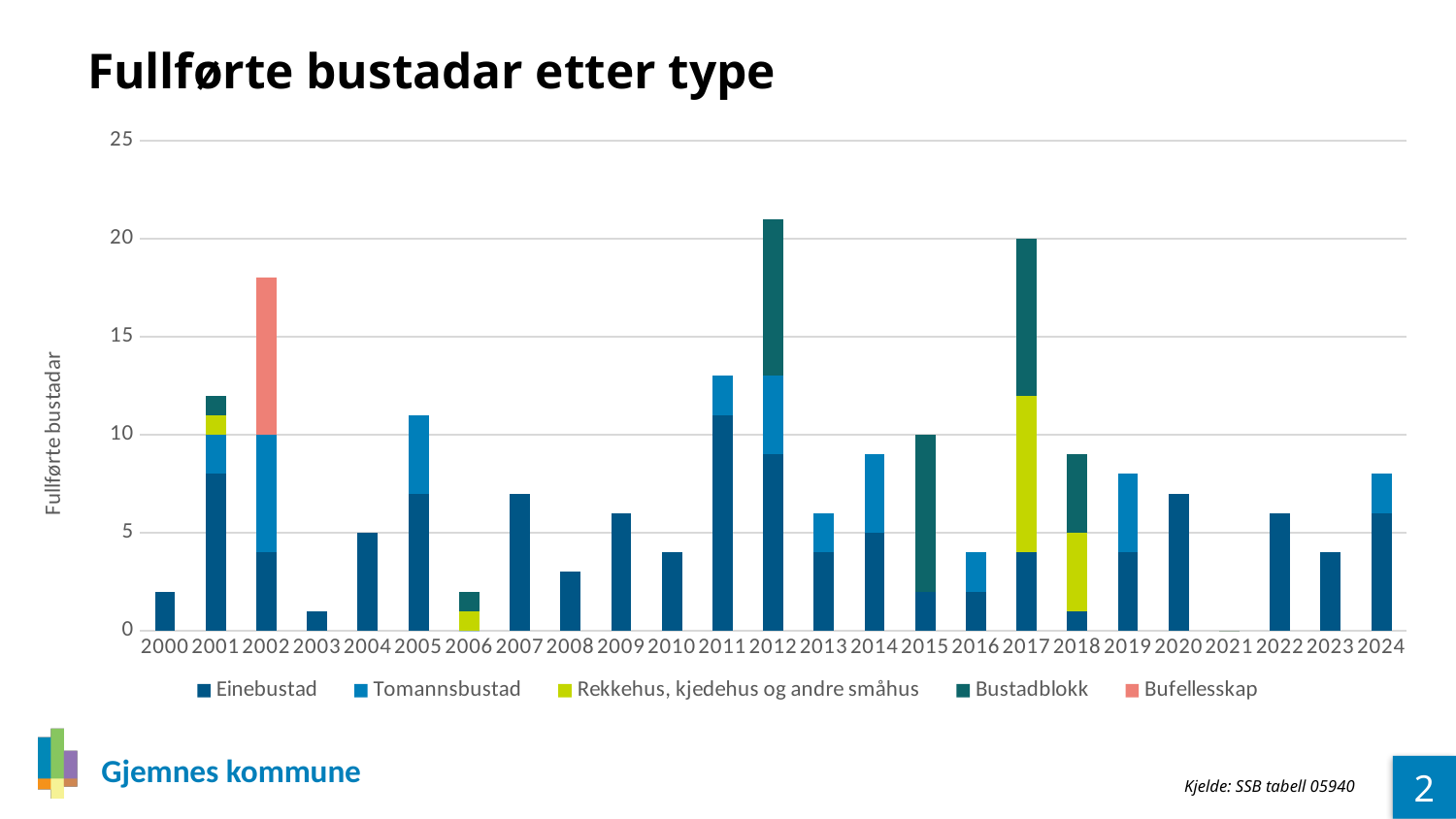
What is the total number of completed dwellings in 2004? 5 What is the total number of completed dwellings in 2017? 20 How many years are shown along the x axis? 25 Which year has a larger total, 2005 or 2010? 2005 Is the total value for 2002 greater or less than 15? greater What is the total number of completed dwellings in 2015? 10 How many series does the legend list? 5 Which year has the highest total of completed dwellings? 2012 What is the title of the chart? Fullførte bustadar etter type What kind of chart is shown on the slide? Stacked bar chart Which year has the lowest total of completed dwellings? 2021 Is the total value for 2000 greater or less than 5? less